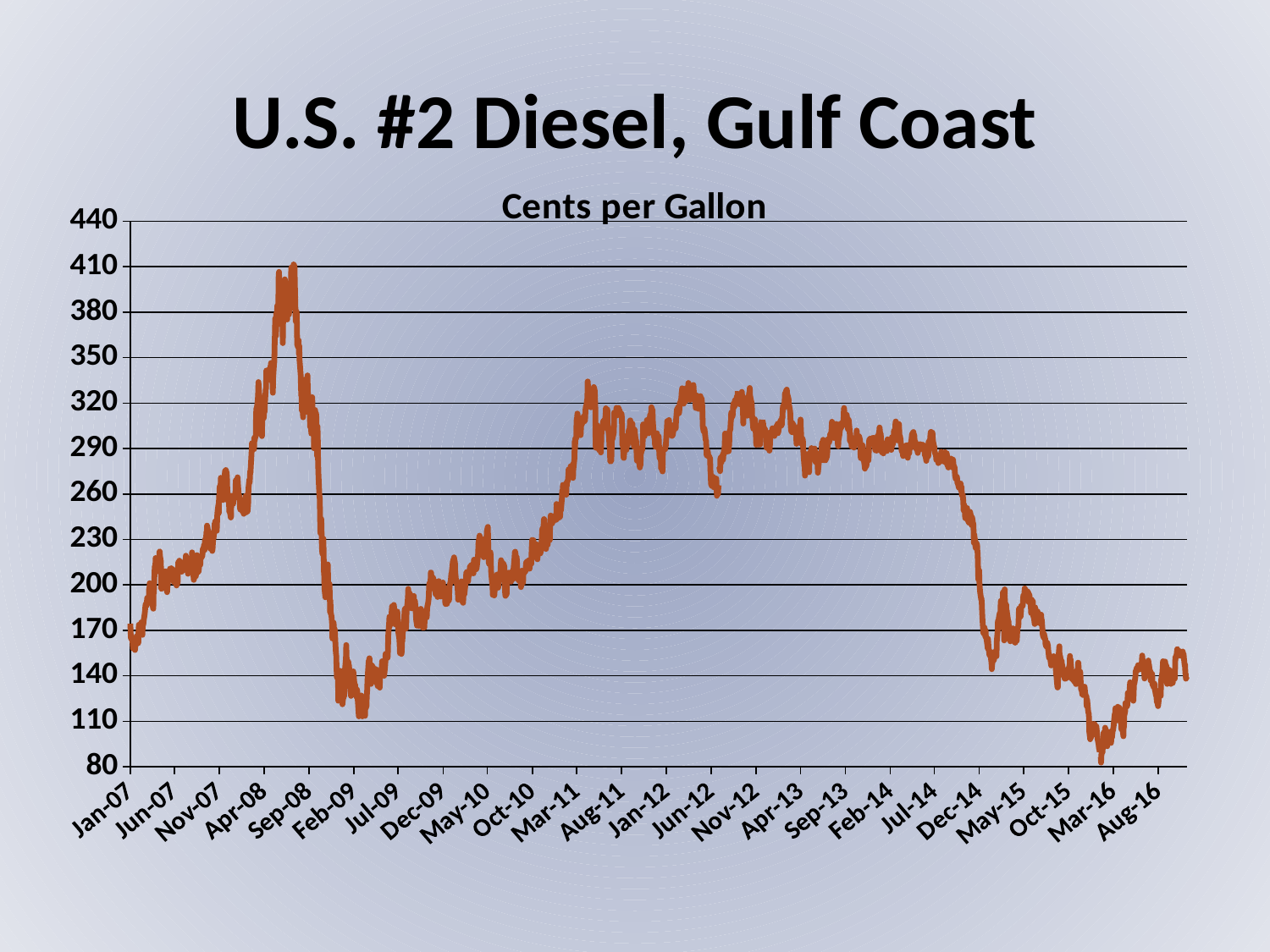
What is the title of the chart? Cents per Gallon Is the value near Mar-16 greater or less than 110? less Is the peak value near Sep-08 greater or less than 380? greater Is the value near Feb-09 greater or less than 140? less What unit is the chart's subtitle stated in? Cents per Gallon Around which x-axis label does the line reach its lowest value? Mar-16 What kind of chart is shown on the slide? Line chart Does the line rise or fall between Jan-07 and Sep-08? Rise Does the line rise or fall between Jul-14 and Mar-16? Fall Around which x-axis label does the line reach its highest value? Sep-08